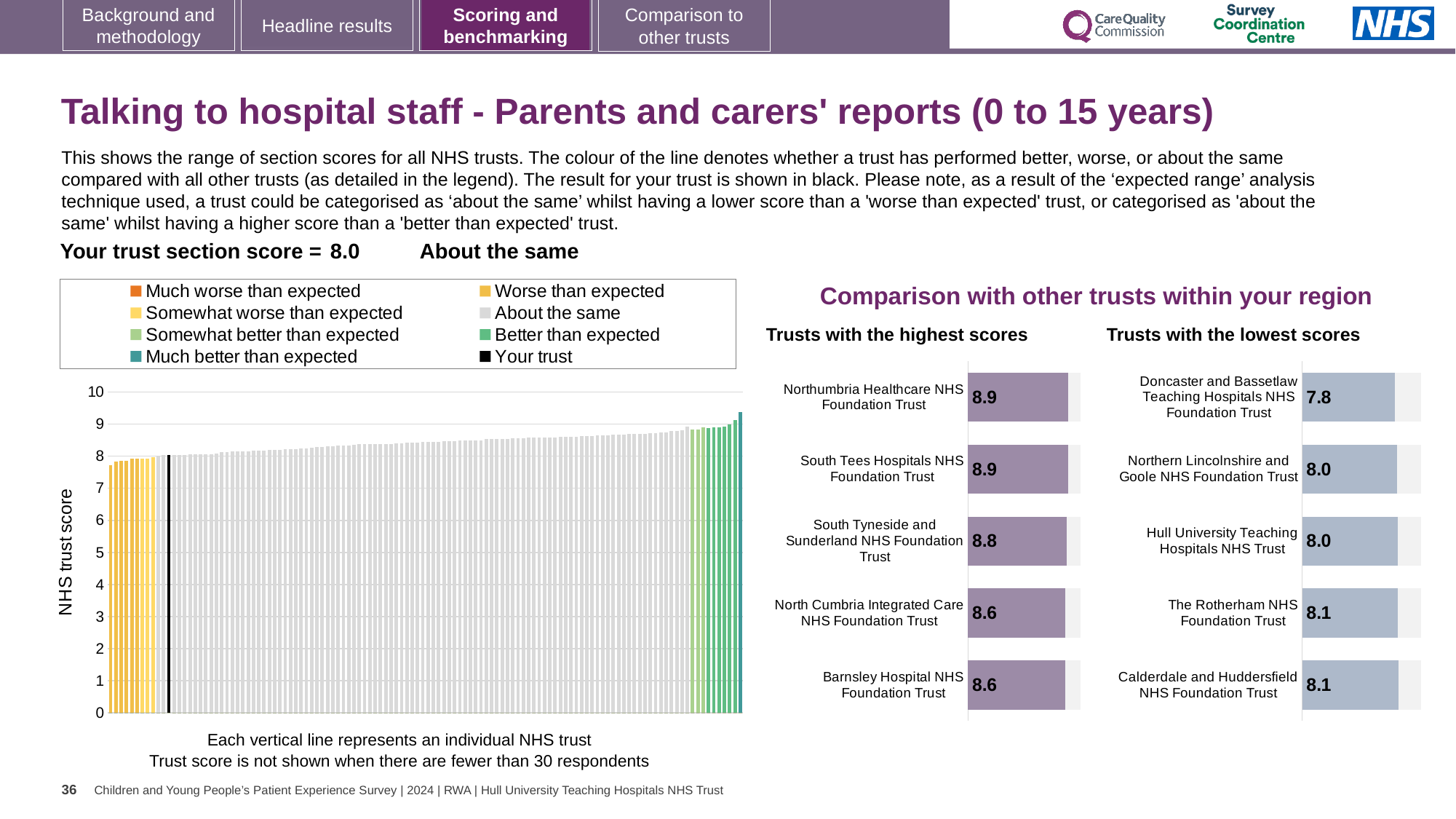
What is the y-axis label of the large chart on the left? NHS trust score How many trusts are shown in the 'Trusts with the highest scores' chart? 5 What is your trust's section score shown on the slide? 8.0 In the 'Trusts with the lowest scores' chart, what is the score for Doncaster and Bassetlaw Teaching Hospitals NHS Foundation Trust? 7.8 What kind of chart is the large chart on the left showing the range of section scores for all NHS trusts? bar chart In the 'Trusts with the highest scores' chart, what is the difference between the scores of Northumbria Healthcare NHS Foundation Trust and Barnsley Hospital NHS Foundation Trust? 0.3 In the 'Trusts with the lowest scores' chart, which trust has the lowest score? Doncaster and Bassetlaw Teaching Hospitals NHS Foundation Trust How many entries does the legend of the large chart on the left list? 8 In the large chart on the left, is the value for your trust (the black bar) greater or less than 5? greater In the 'Trusts with the lowest scores' chart, what is the score for The Rotherham NHS Foundation Trust? 8.1 In the 'Trusts with the highest scores' chart, what is the score for South Tyneside and Sunderland NHS Foundation Trust? 8.8 Which has the higher score: North Cumbria Integrated Care NHS Foundation Trust in the highest scores chart or Hull University Teaching Hospitals NHS Trust in the lowest scores chart? North Cumbria Integrated Care NHS Foundation Trust